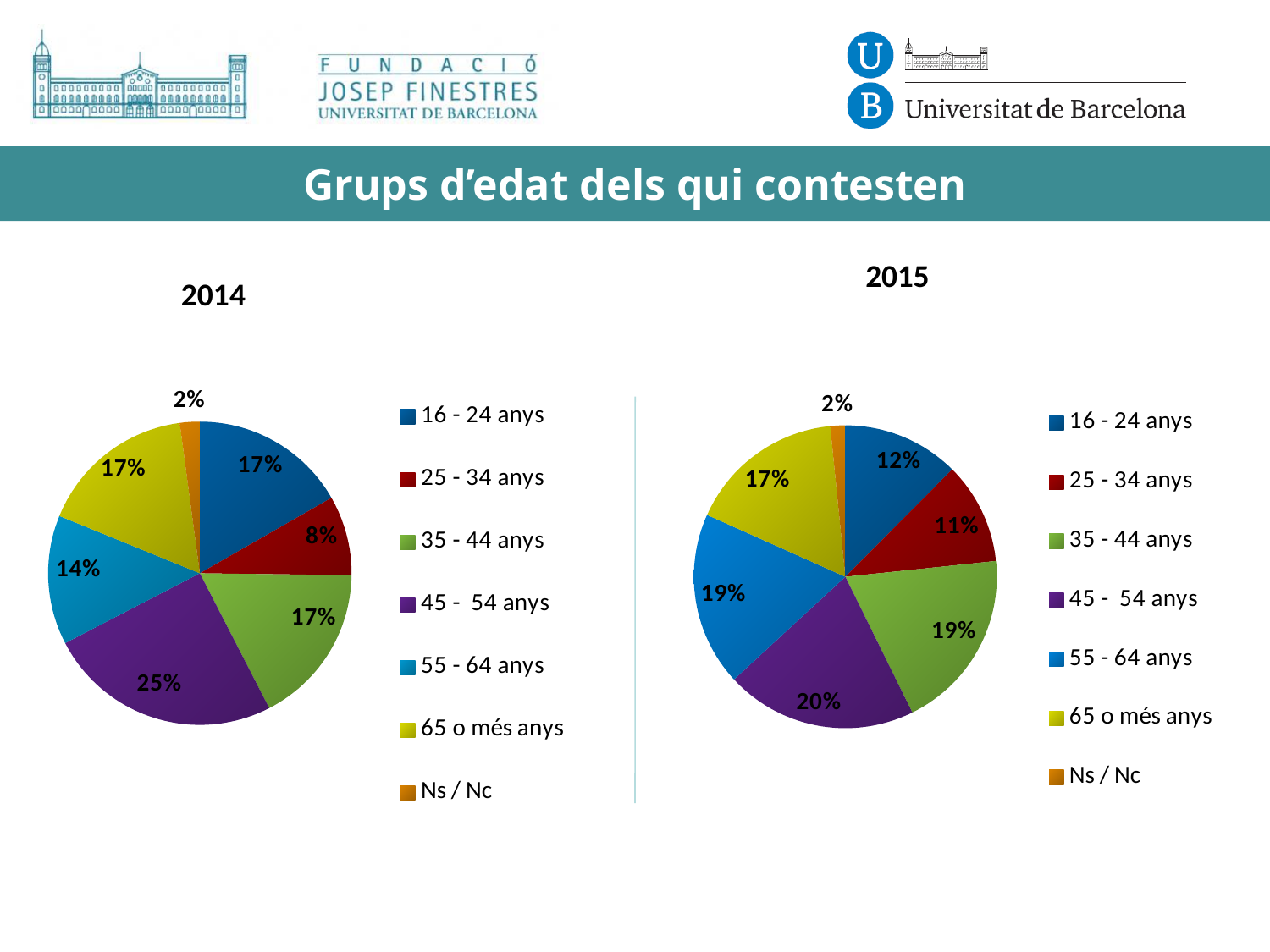
What type of chart is used to show the 2014 data? Pie chart In the 2015 pie chart, which is larger: the share for 25 - 34 anys or the share for 35 - 44 anys? 35 - 44 anys In the 2015 pie chart, which category has the smallest share? Ns / Nc What is the title shown above the two pie charts? Grups d'edat dels qui contesten In the 2014 pie chart, what is the value for 25 - 34 anys? 8% In the 2015 pie chart, what is the value for 55 - 64 anys? 19% In the 2014 pie chart, what share do the 45 - 54 anys respondents represent? 25% In the 2015 pie chart, what share do the 16 - 24 anys respondents represent? 12% In the 2014 pie chart, which age group has the largest share? 45 - 54 anys In the 2014 pie chart, what is the combined share of 16 - 24 anys and 25 - 34 anys? 25% How many categories does the legend of the 2015 pie chart list? 7 In the 2014 pie chart, what is the difference between the 45 - 54 anys share and the 55 - 64 anys share? 11%